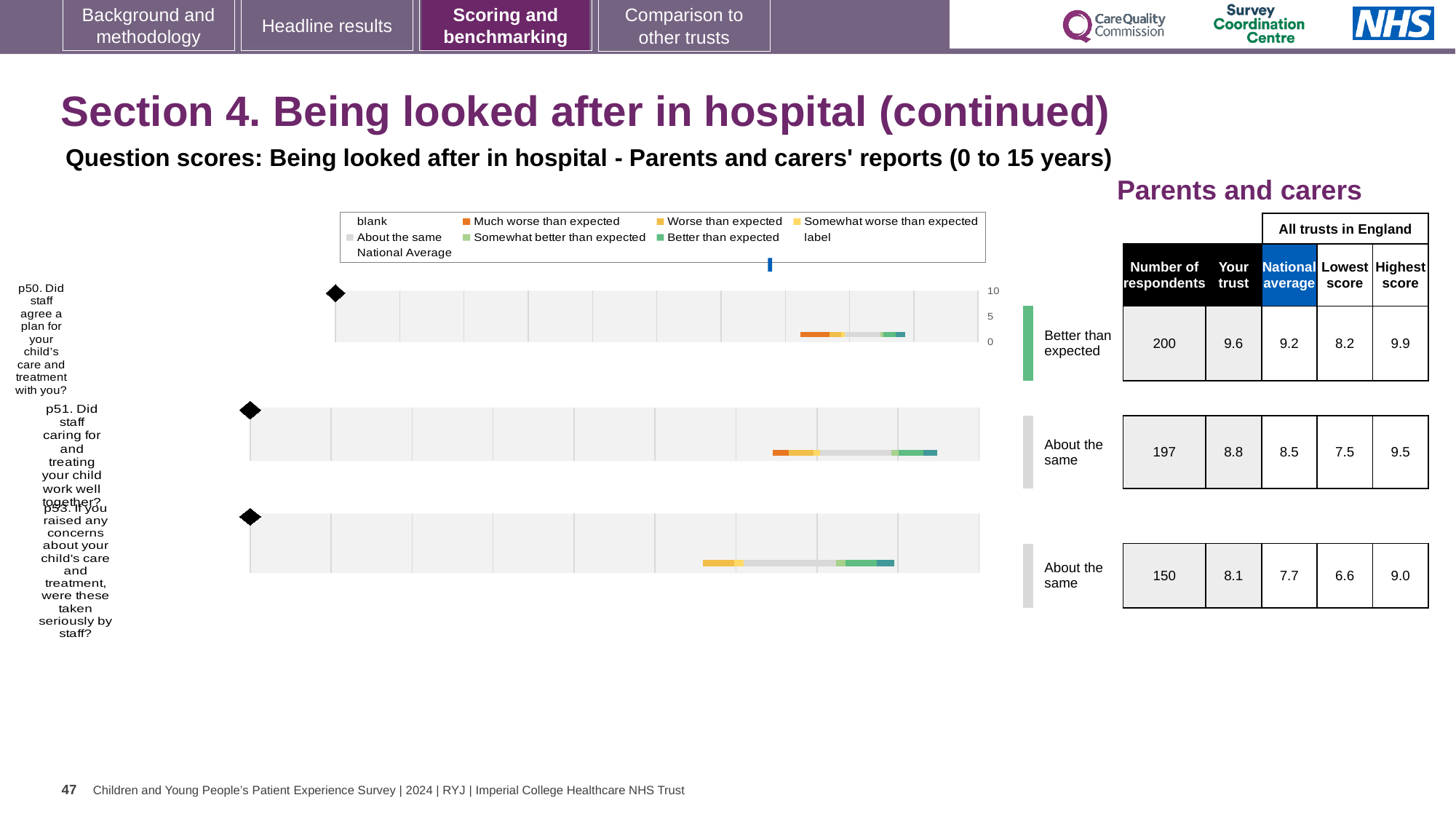
For the p50 chart, what is the highest score among all trusts in England? 9.9 How many entries does the chart legend list? 9 What benchmark category is shown for the p50 chart? Better than expected For the p53 chart, which is larger: the 'Your trust' score or the national average? Your trust For the p50 chart (Did staff agree a plan for your child's care and treatment with you?), what is the 'Your trust' score? 9.6 Which of the three questions has the lowest number of respondents? p53 How many questions (p50, p51, p53) have a score chart on this slide? 3 Which of the three questions has the highest 'Your trust' score? p50 For the p51 chart (Did staff caring for and treating your child work well together?), what is the national average score? 8.5 For the p53 chart (If you raised any concerns about your child's care and treatment, were these taken seriously by staff?), what is the lowest score among all trusts in England? 6.6 For the p50 chart, what is the difference between the 'Your trust' score and the national average? 0.4 What kind of chart is used to show the question scores for p50, p51 and p53? Bar chart